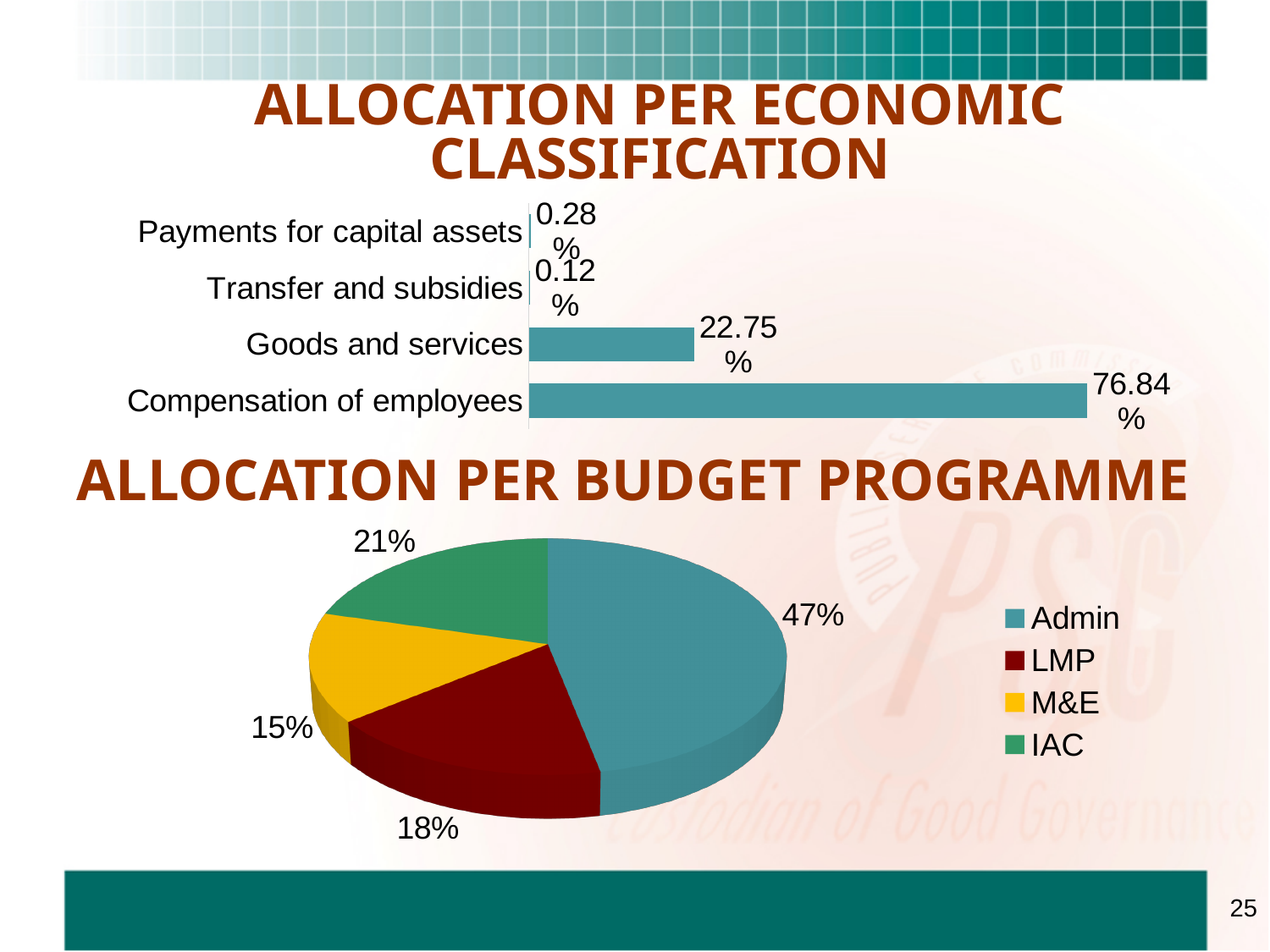
How many entries does the legend of the 'Allocation per budget programme' chart list? 4 In the 'Allocation per economic classification' chart, what is the value for Transfer and subsidies? 0.12% In the 'Allocation per economic classification' chart, what is the value for Compensation of employees? 76.84% In the 'Allocation per economic classification' chart, which category has the lowest value? Transfer and subsidies In the 'Allocation per economic classification' chart, which category has the highest value? Compensation of employees In the 'Allocation per budget programme' chart, what share does M&E have? 15% In the 'Allocation per budget programme' chart, what share does Admin have? 47% In the 'Allocation per economic classification' chart, how many categories are shown? 4 In the 'Allocation per budget programme' chart, which is larger, LMP or IAC? IAC In the 'Allocation per economic classification' chart, what is the difference between Compensation of employees and Goods and services? 54.09% What type of chart is the 'Allocation per economic classification' chart? Bar chart In the 'Allocation per economic classification' chart, what is the value for Goods and services? 22.75%